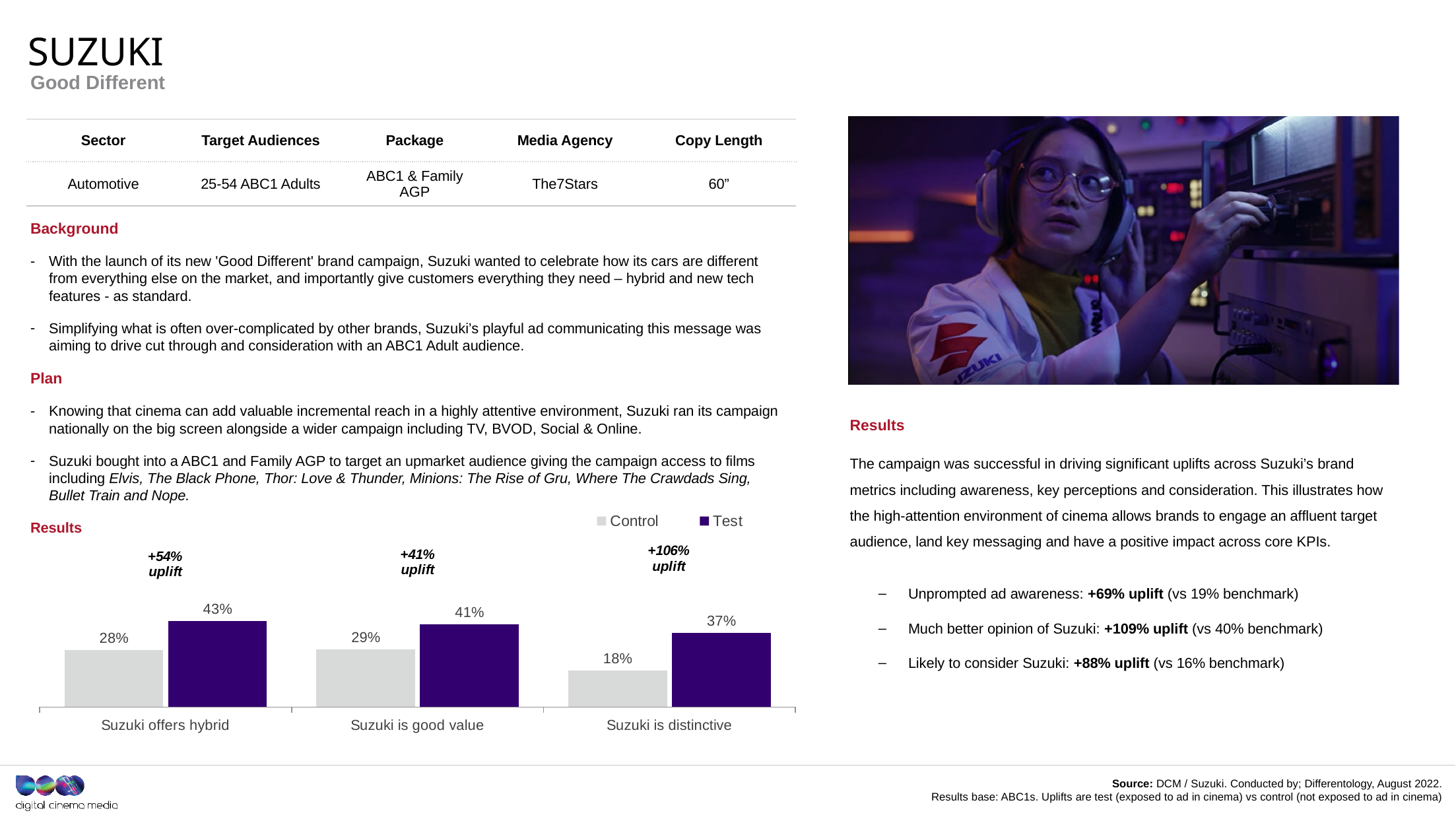
Which is larger: the Test value for 'Suzuki is good value' or the Test value for 'Suzuki is distinctive'? Suzuki is good value How many categories are shown on the x axis of the chart? 3 What is the difference between the Test and Control values for 'Suzuki is distinctive'? 19% What uplift is annotated above the 'Suzuki is distinctive' bars? +106% uplift What is the difference between the Test and Control values for 'Suzuki offers hybrid'? 15% What is the Control value for 'Suzuki is distinctive'? 18% What is the Test value for 'Suzuki offers hybrid'? 43% Which category has the highest Test value? Suzuki offers hybrid What kind of chart is shown on the slide? Bar chart How many series does the chart legend list? 2 What is the Control value for 'Suzuki is good value'? 29% Which category has the lowest Control value? Suzuki is distinctive